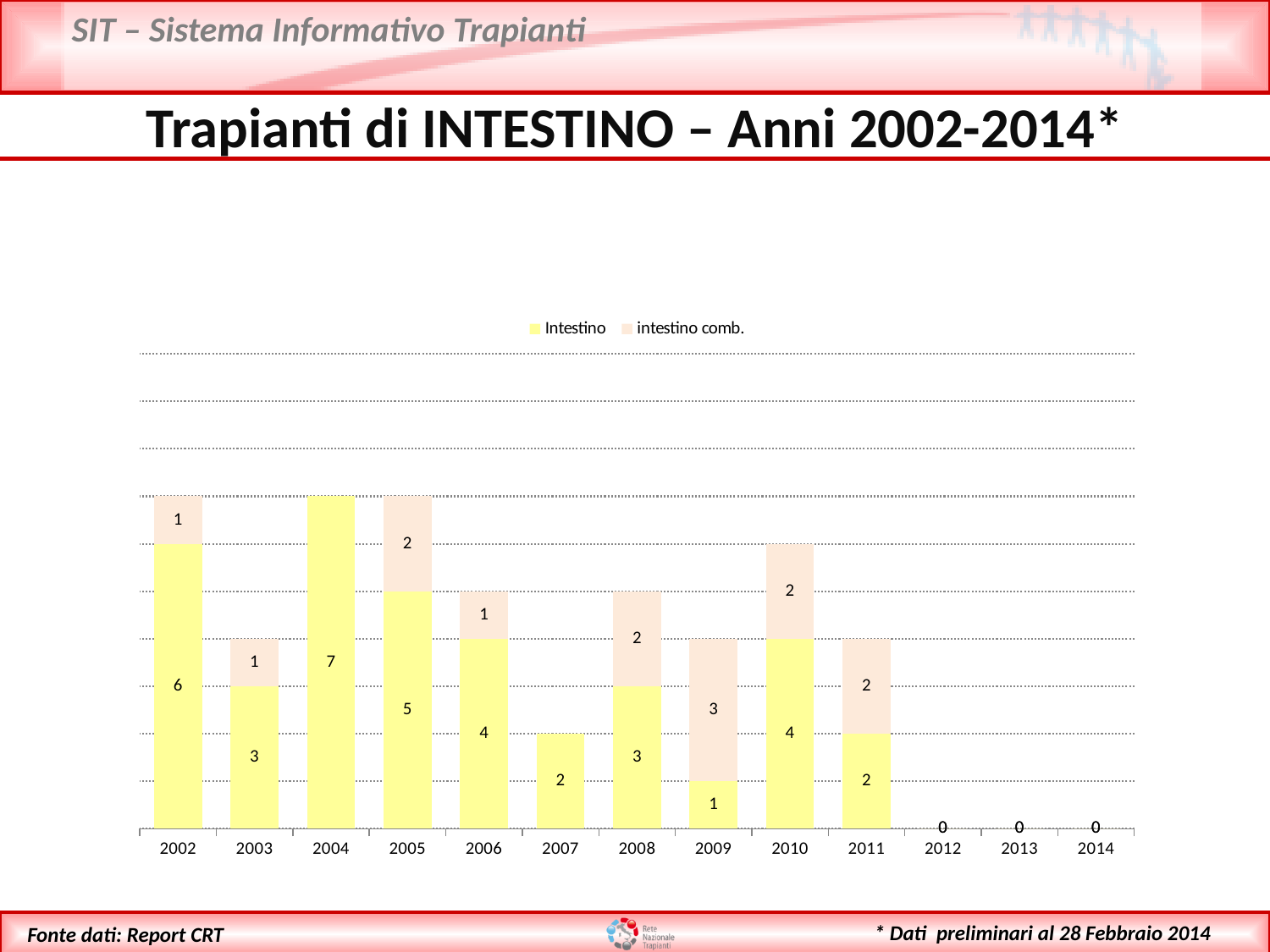
How many years are shown on the x axis? 13 What is the difference between the Intestino values for 2002 and 2003? 3 Which year has the highest value for the Intestino series? 2004 What is the value for Intestino in 2006? 4 What is the total of the stacked bar for 2002? 7 How many series does the legend list? 2 What are the two entries in the chart legend? Intestino and intestino comb. What is the total of the stacked bar for 2010? 6 What is the value shown for 2012? 0 Which year has the larger intestino comb. value, 2005 or 2006? 2005 What is the value for intestino comb. in 2009? 3 What kind of chart is shown on the slide? Stacked bar chart